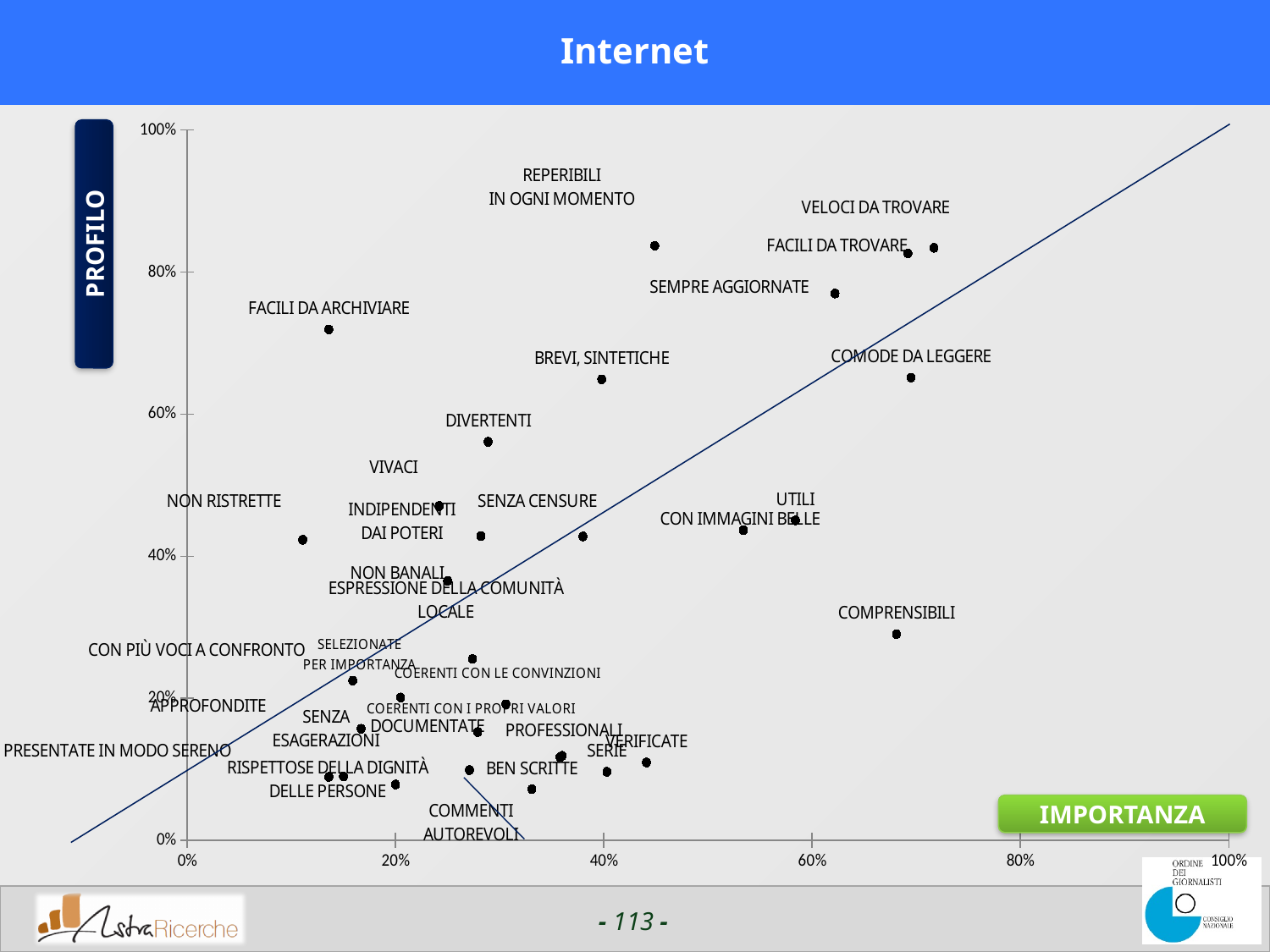
Is the IMPORTANZA value for NON RISTRETTE greater or less than 20%? less Is the IMPORTANZA value for COMPRENSIBILI greater or less than 60%? greater Is the PROFILO value for COMPRENSIBILI greater or less than 40%? less What label is given to the vertical axis of the chart? PROFILO What kind of chart is shown on the slide? scatter chart Which has the higher PROFILO value, BREVI, SINTETICHE or VERIFICATE? BREVI, SINTETICHE What is the title of the chart? Internet Which has the higher PROFILO value, FACILI DA ARCHIVIARE or DIVERTENTI? FACILI DA ARCHIVIARE Which has the higher IMPORTANZA value, COMPRENSIBILI or NON RISTRETTE? COMPRENSIBILI